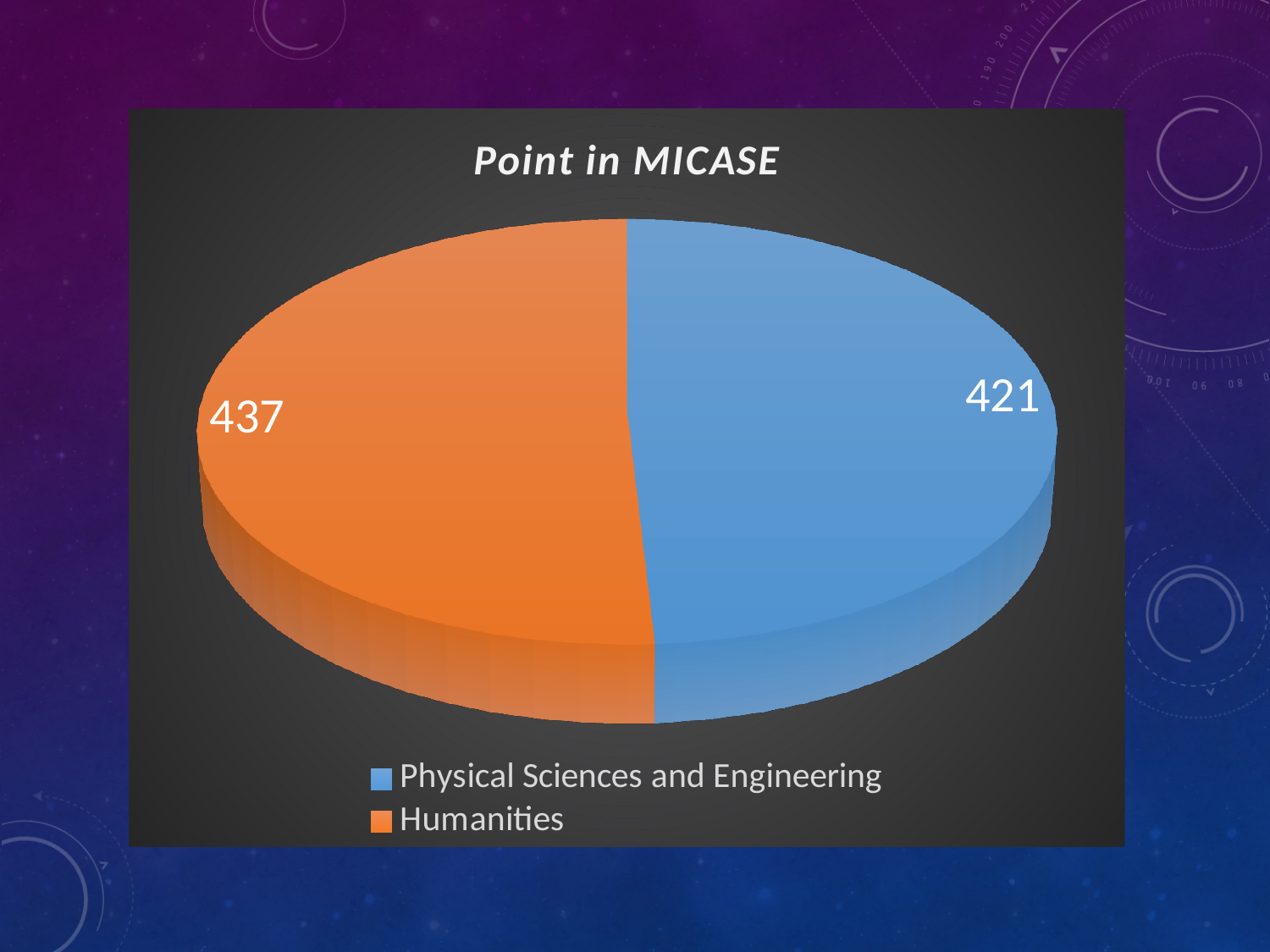
What type of chart is shown on the slide? pie chart What is the value for Physical Sciences and Engineering? 421 Which category has the larger value? Humanities What is the difference between the Humanities value and the Physical Sciences and Engineering value? 16 What is the title of the chart? Point in MICASE Which category has the smaller value? Physical Sciences and Engineering Which colour represents Humanities in the chart? orange Is the value for Humanities larger or smaller than the value for Physical Sciences and Engineering? larger How many slices does the pie chart have? 2 What is the total of the two slices in the pie chart? 858 What is the value for Humanities? 437